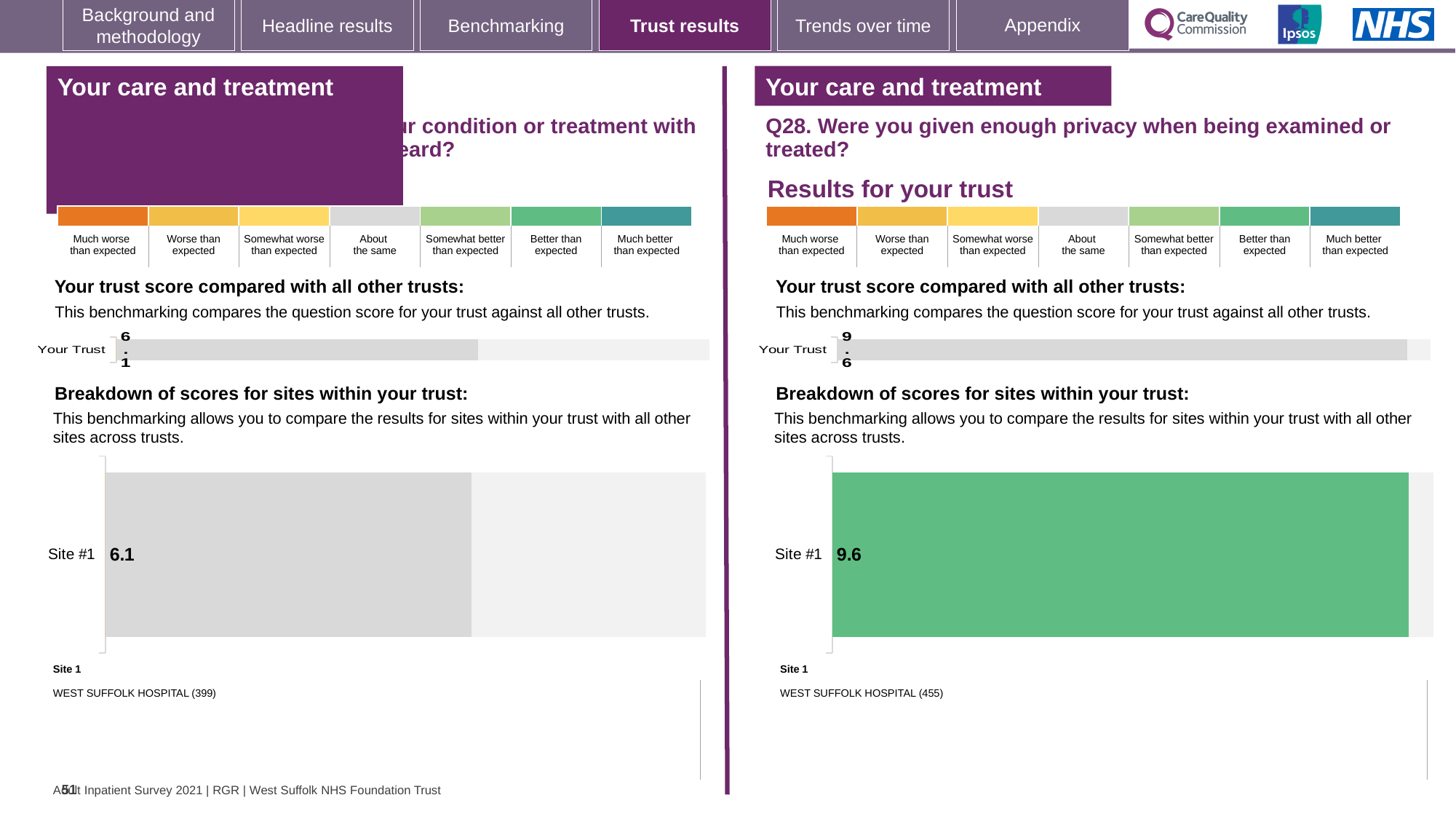
Which is larger: the Site #1 score in the left-hand breakdown chart or the Site #1 score in the right-hand (Q28) breakdown chart? The right-hand (Q28) chart On the left-hand side of the slide, what is the score shown for Your Trust in the 'Your trust score compared with all other trusts' chart? 6.1 On the right-hand side of the slide (Q28), what is the score shown for Your Trust in the 'Your trust score compared with all other trusts' chart? 9.6 What type of chart is used for the 'Breakdown of scores for sites within your trust' on the left-hand side of the slide? Bar chart What colour is the Site #1 bar in the right-hand (Q28) breakdown chart? Green In the right-hand (Q28) 'Your trust score compared with all other trusts' chart, how many bars are plotted? 1 What is the difference between the Site #1 score in the right-hand (Q28) breakdown chart and the Site #1 score in the left-hand breakdown chart? 3.5 In the 'Breakdown of scores for sites within your trust' chart on the left-hand side, what is the score for Site #1? 6.1 Which site name is listed as Site 1 beneath the right-hand (Q28) breakdown chart? WEST SUFFOLK HOSPITAL (455) How many sites are plotted in the 'Breakdown of scores for sites within your trust' chart on the right-hand side (Q28)? 1 In the 'Breakdown of scores for sites within your trust' chart on the right-hand side (Q28), what is the score for Site #1? 9.6